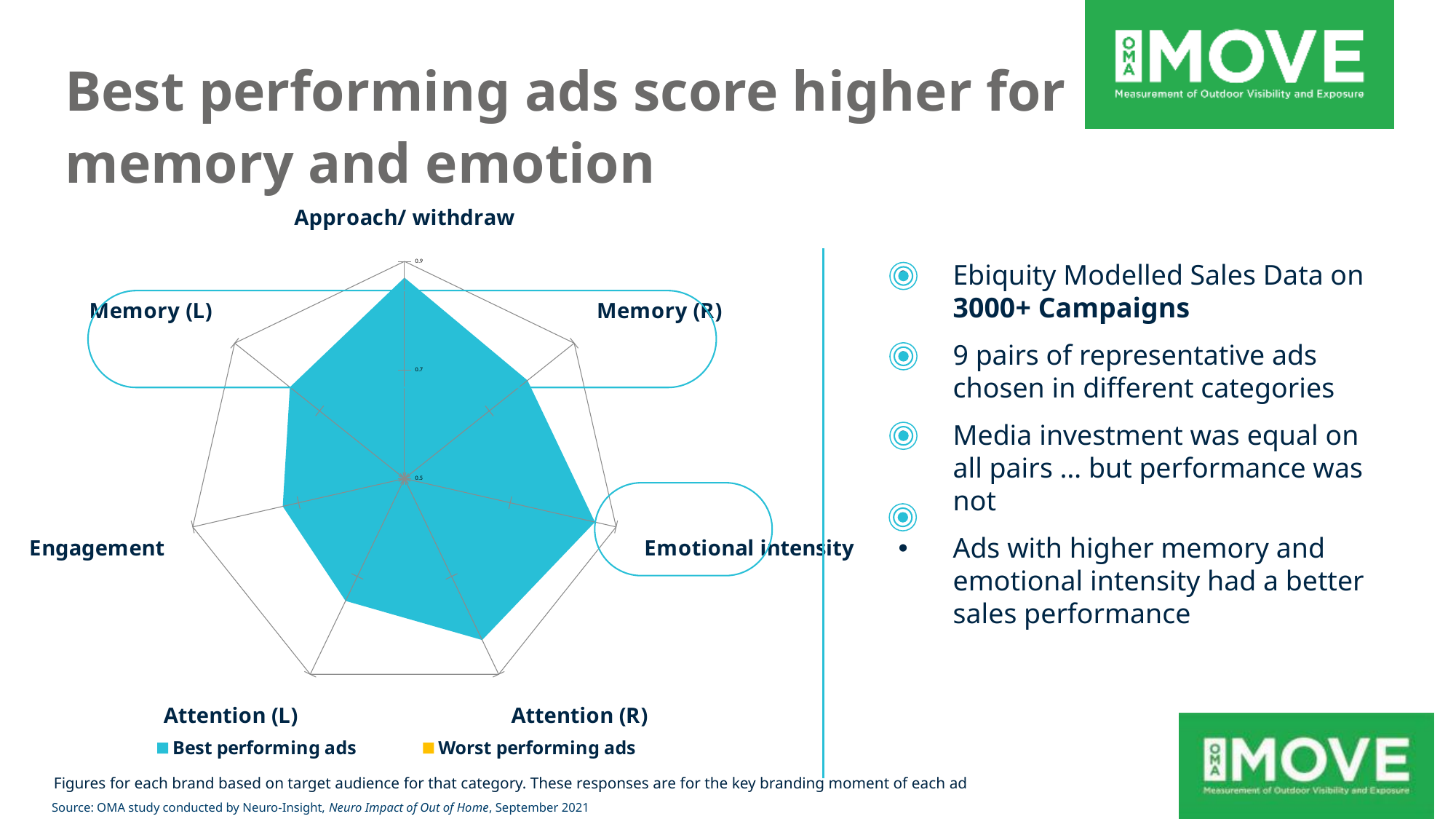
Is the value for Memory (R) for Best performing ads greater or less than 0.7? greater For Best performing ads, which is larger: Emotional intensity or Attention (L)? Emotional intensity For Best performing ads, which is larger: Approach/ withdraw or Engagement? Approach/ withdraw Is the value for Engagement for Best performing ads greater or less than 0.9? less How many categories (axes) does the radar chart have? 7 How many series does the chart legend list? 2 What are the two series named in the chart legend? Best performing ads and Worst performing ads What kind of chart is shown on the slide? Radar chart What colour represents Best performing ads in the legend? Blue Is the value for Approach/ withdraw for Best performing ads greater or less than 0.7? greater